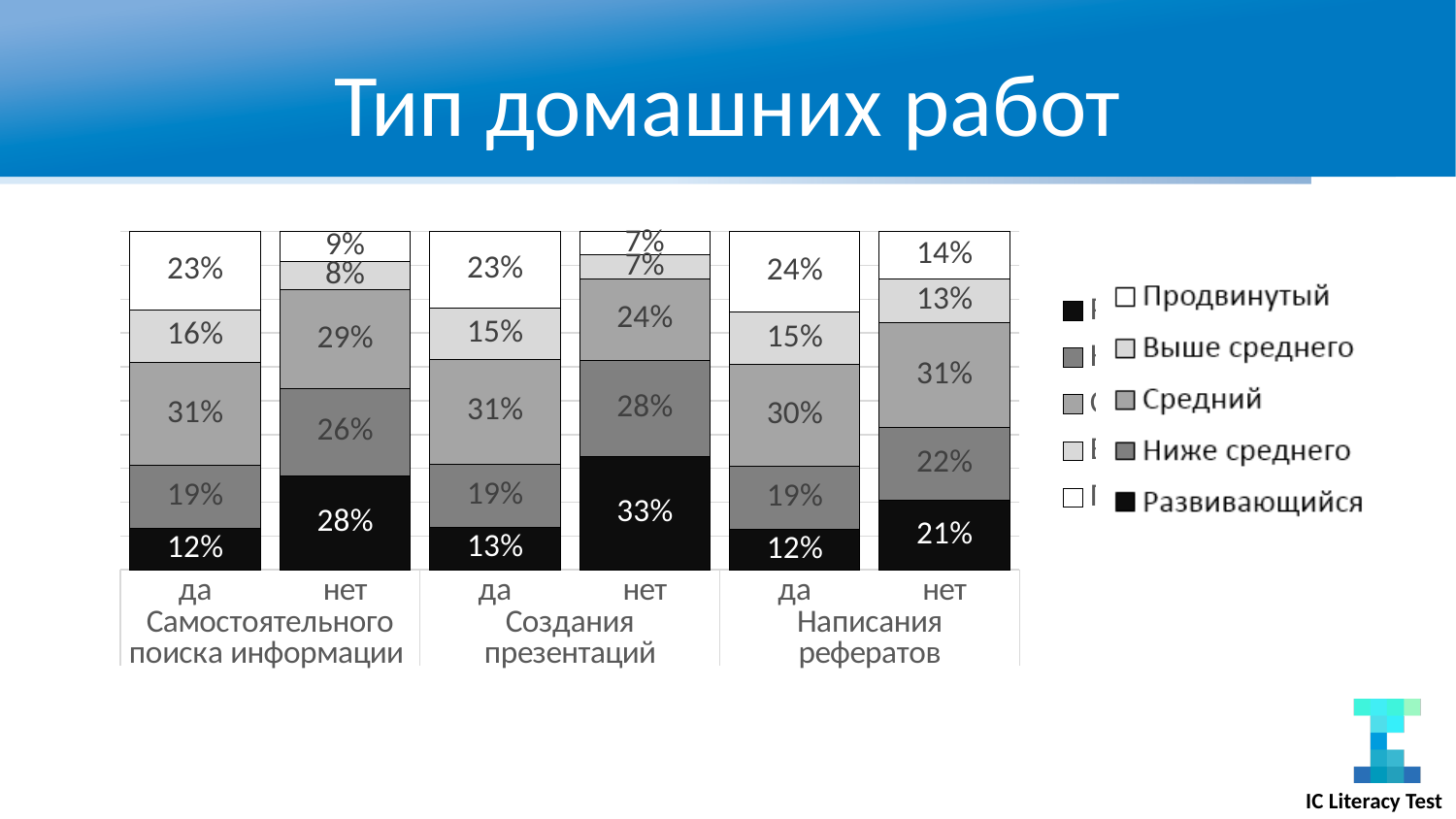
How many series does the legend list? 5 What kind of chart is shown on the slide? stacked bar chart Which is larger: the Продвинутый value for 'да' under Самостоятельного поиска информации or for 'нет' under Написания рефератов? да under Самостоятельного поиска информации What is the value of the Выше среднего segment for the 'нет' bar under Написания рефератов? 13% How many bars are plotted in the chart? 6 What is the difference between the Развивающийся values for 'нет' and 'да' under Самостоятельного поиска информации? 16% What is the value of the Развивающийся segment for the 'нет' bar under Создания презентаций? 33% Which bar has the highest Развивающийся value? нет, Создания презентаций Which legend entry is shown in black? Развивающийся Which bar has the lowest Продвинутый value? нет, Создания презентаций What is the value of the Продвинутый segment for the 'да' bar under Написания рефератов? 24% What is the value of the Средний segment for the 'нет' bar under Самостоятельного поиска информации? 29%